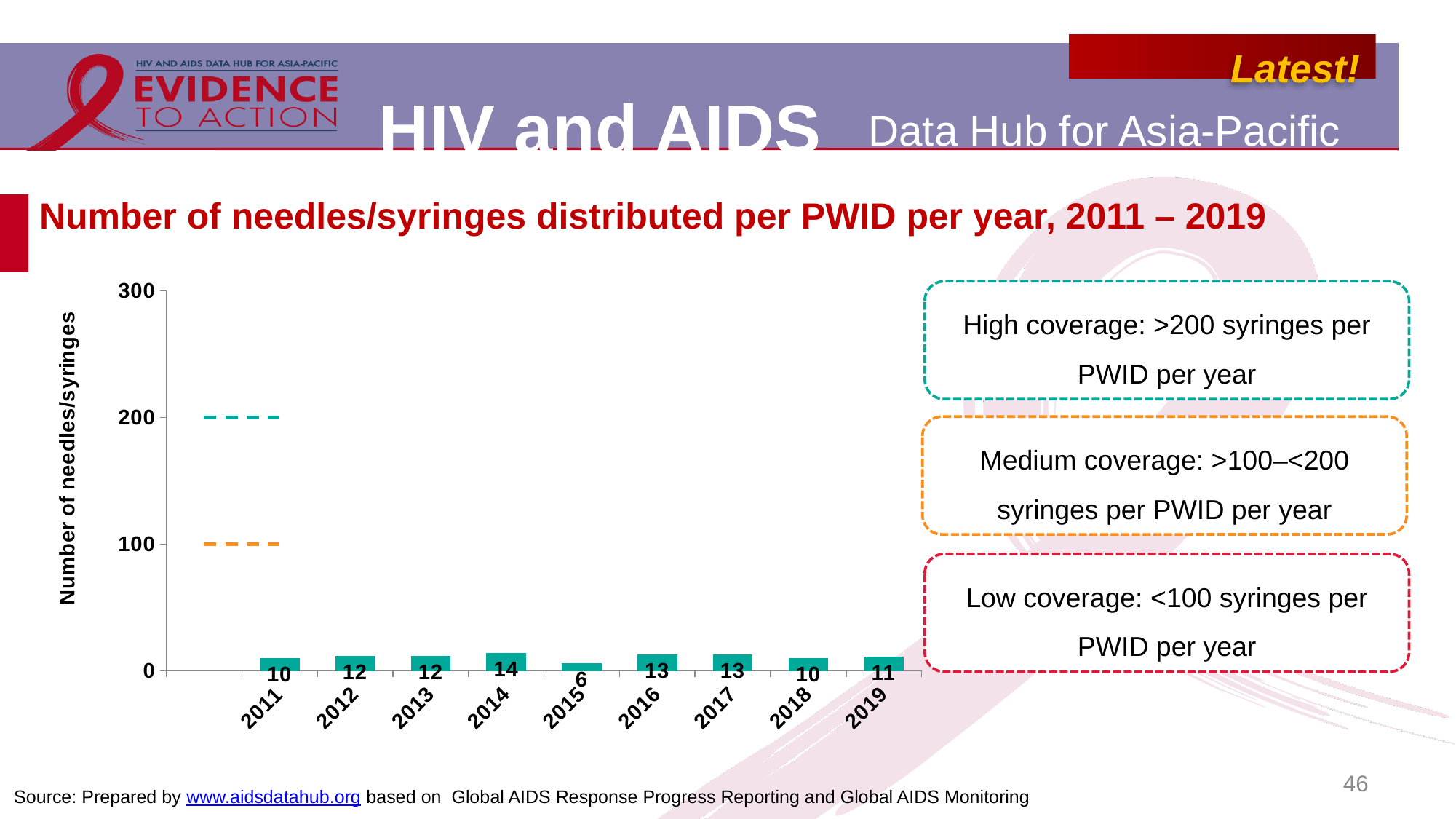
Which year has a larger value, 2016 or 2018? 2016 Which year has the highest number of needles/syringes distributed per PWID? 2014 What is the number of needles/syringes distributed per PWID in 2014? 14 According to the slide, what level of coverage is more than 200 syringes per PWID per year? High coverage What kind of chart is used to show the number of needles/syringes distributed per PWID per year? bar chart What is the number of needles/syringes distributed per PWID in 2019? 11 How many years are shown on the x axis of the chart? 9 What is the number of needles/syringes distributed per PWID in 2015? 6 Is the value for 2017 greater or less than 100? less What is the difference between the values for 2014 and 2015? 8 Which year has the lowest number of needles/syringes distributed per PWID? 2015 What is the label of the y axis of the chart? Number of needles/syringes